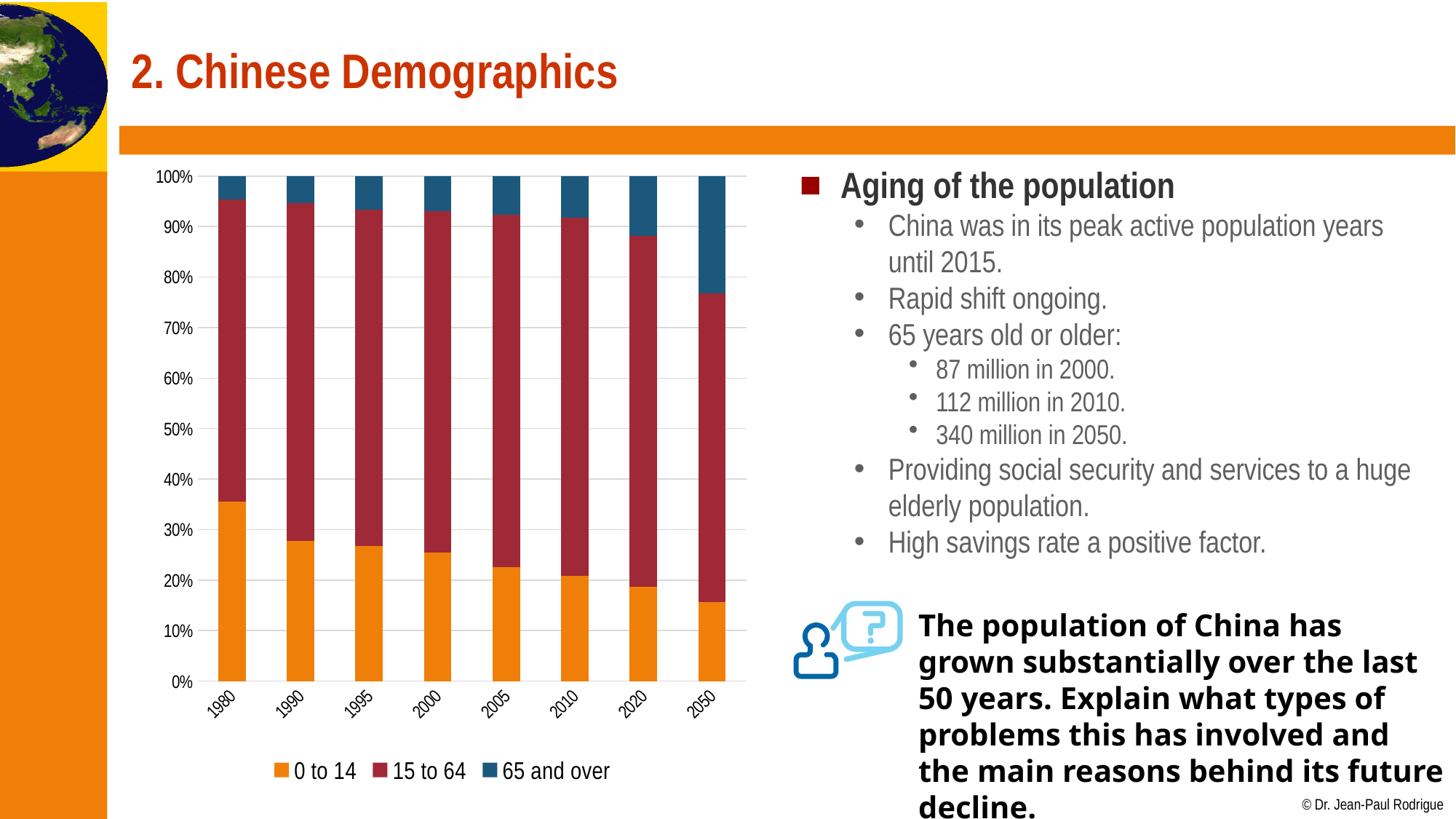
In which year is the share of the 0 to 14 age group the lowest? 2050 Which is larger: the share of the 65 and over group in 1980 or in 2020? 2020 Is the share of the 65 and over age group in 2050 greater or less than 20%? greater Which age groups are listed in the chart legend? 0 to 14, 15 to 64, 65 and over What colour represents the 65 and over age group in the chart? Blue How many series does the chart legend list? 3 In which year is the share of the 0 to 14 age group the highest? 1980 What kind of chart is shown on the slide? Stacked bar chart Is the share of the 0 to 14 age group in 1980 greater or less than 30%? greater Does the share of the 0 to 14 age group rise or fall from 1980 to 2050? Fall In which year is the share of the 65 and over age group the largest? 2050 How many years are shown along the x axis of the chart? 8